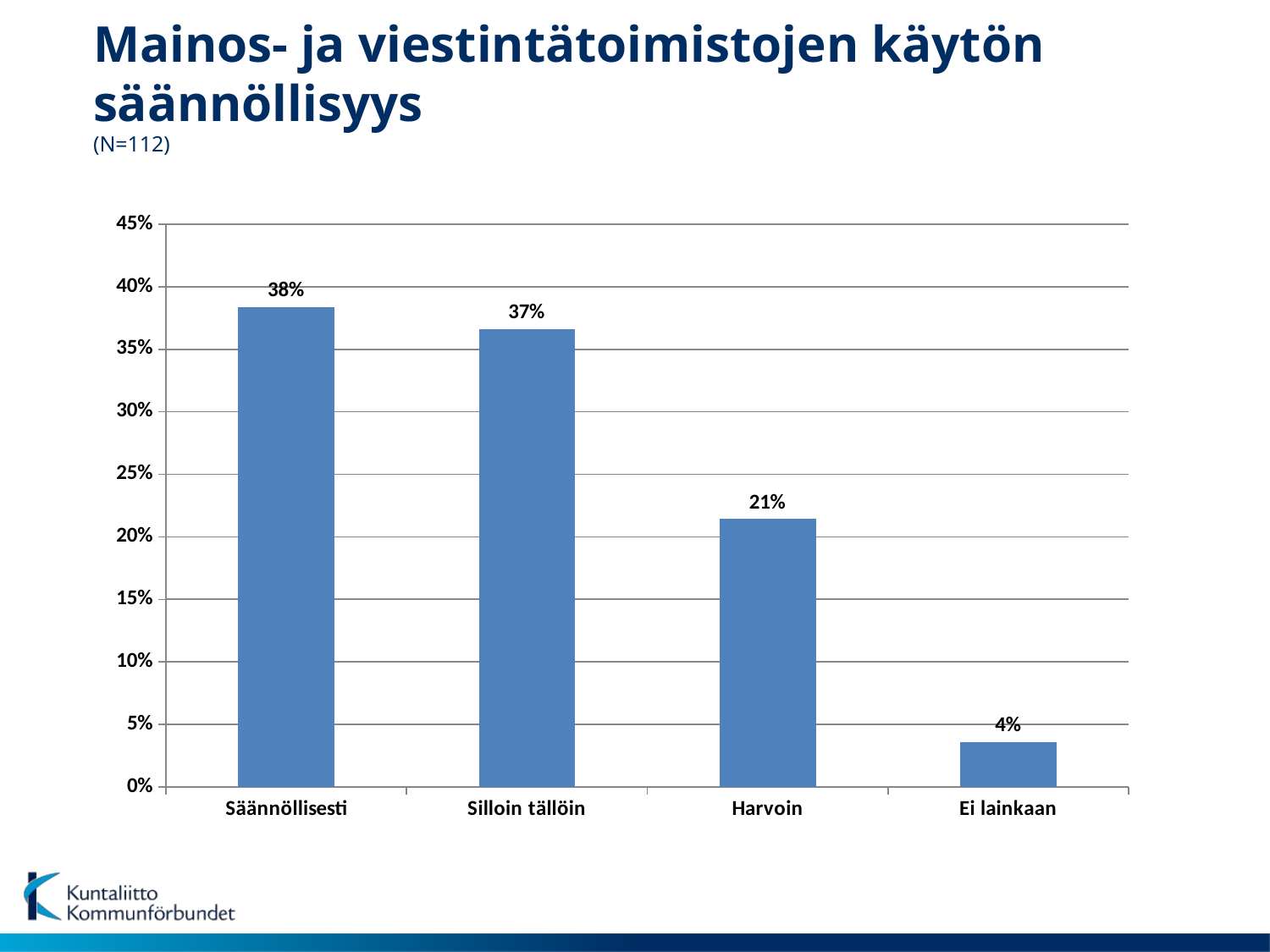
What is the value for Ei lainkaan? 4% What is the value for Harvoin? 21% What is the difference between the values for Harvoin and Ei lainkaan? 17% What is the difference between the values for Säännöllisesti and Harvoin? 17% What is the value for Säännöllisesti? 38% Which is larger, the value for Silloin tällöin or the value for Harvoin? Silloin tällöin How many categories are shown on the x axis? 4 Which category has the lowest value? Ei lainkaan What is the value for Silloin tällöin? 37% What kind of chart is shown on the slide? bar chart Is the value for Harvoin greater or less than 25%? less What is the sample size (N) stated under the chart title? N=112